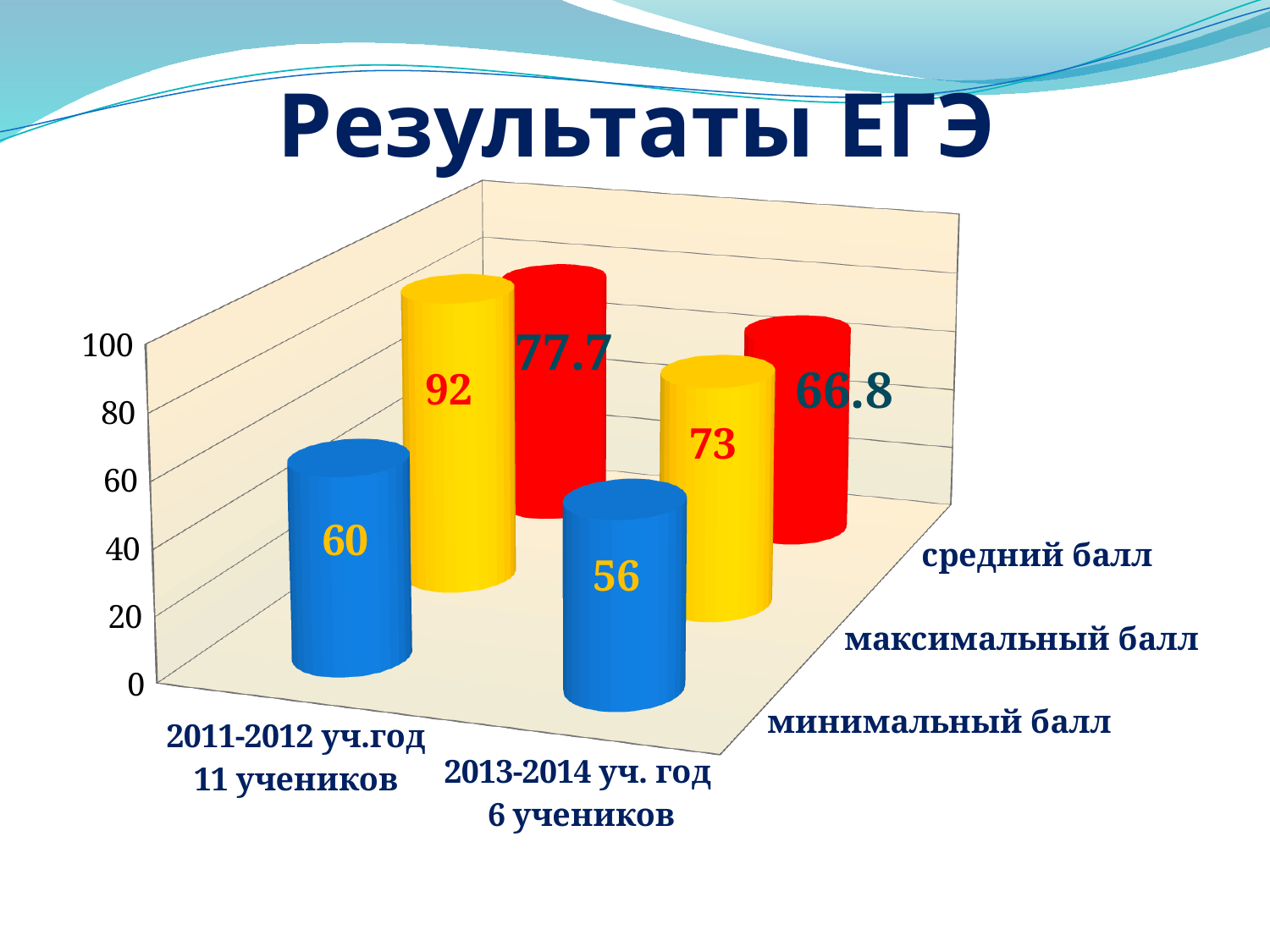
How many academic years (categories) are shown on the chart? 2 What is the maximum score (максимальный балл) for 2013-2014 уч. год? 73 What is the minimum score (минимальный балл) for 2011-2012 уч.год? 60 What is the average score (средний балл) for 2011-2012 уч.год? 77.7 What is the title of the chart? Результаты ЕГЭ Is the average score for 2011-2012 larger or smaller than the average score for 2013-2014? larger How many series (score types) does the chart show? 3 Which academic year has the lower minimum score (минимальный балл)? 2013-2014 уч. год Which academic year has the higher maximum score (максимальный балл)? 2011-2012 уч.год What is the average score (средний балл) for 2013-2014 уч. год? 66.8 What is the difference between the maximum scores of 2011-2012 and 2013-2014? 19 What is the difference between the average scores of 2011-2012 and 2013-2014? 10.9